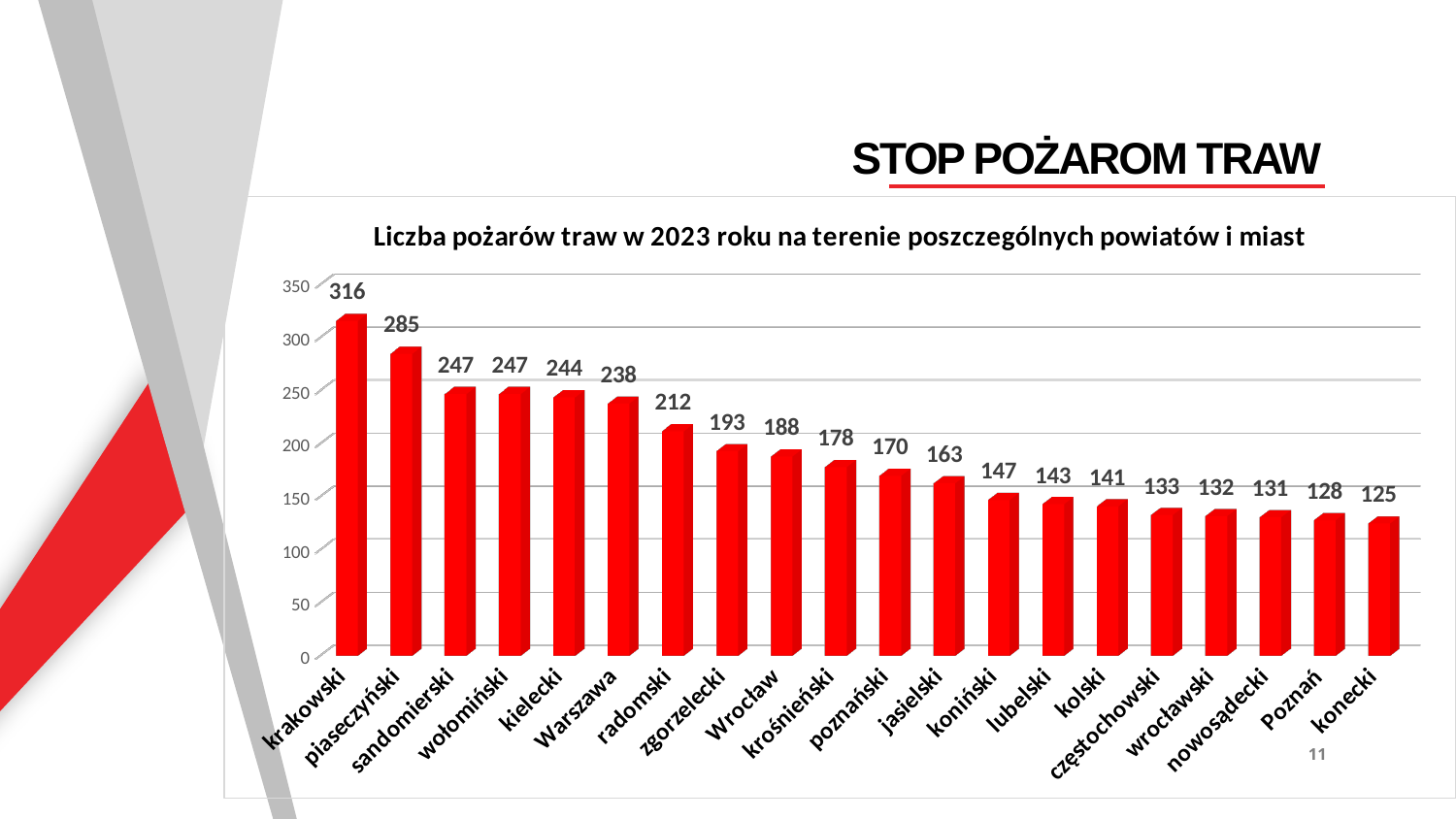
How many categories are shown on the x axis? 20 What is the value for Warszawa? 238 What is the value for Wrocław? 188 What is the value for krakowski? 316 What kind of chart is this? bar chart Which is larger, the value for radomski or the value for zgorzelecki? radomski Which category has the highest value? krakowski What is the value for Poznań? 128 Do the values rise or fall from left to right along the x axis? fall What is the difference between the values for krakowski and piaseczyński? 31 What is the title of the chart? Liczba pożarów traw w 2023 roku na terenie poszczególnych powiatów i miast Which category has the lowest value? konecki